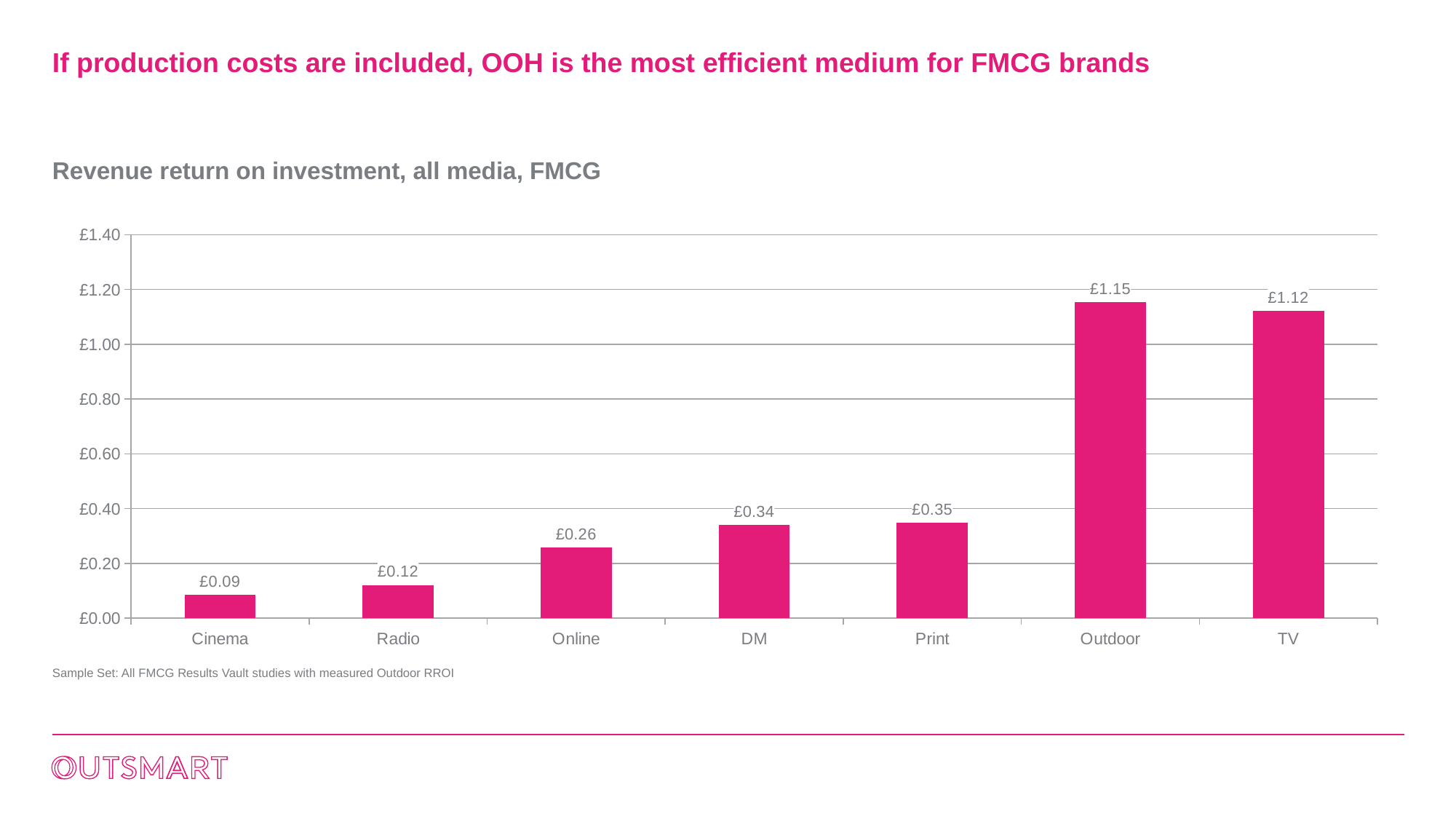
What is the difference between the values for Print and Radio? £0.23 Which has a higher value, DM or Print? Print How many media categories are shown on the chart? 7 What is the difference between the values for Outdoor and TV? £0.03 Which medium has the lowest revenue return on investment? Cinema What kind of chart is shown on the slide? Bar chart What is the title of the chart? Revenue return on investment, all media, FMCG Which medium has the highest revenue return on investment? Outdoor What is the revenue return on investment for Outdoor? £1.15 Is the value for TV greater or less than £1.00? greater What is the revenue return on investment for Cinema? £0.09 What is the value shown for Online? £0.26